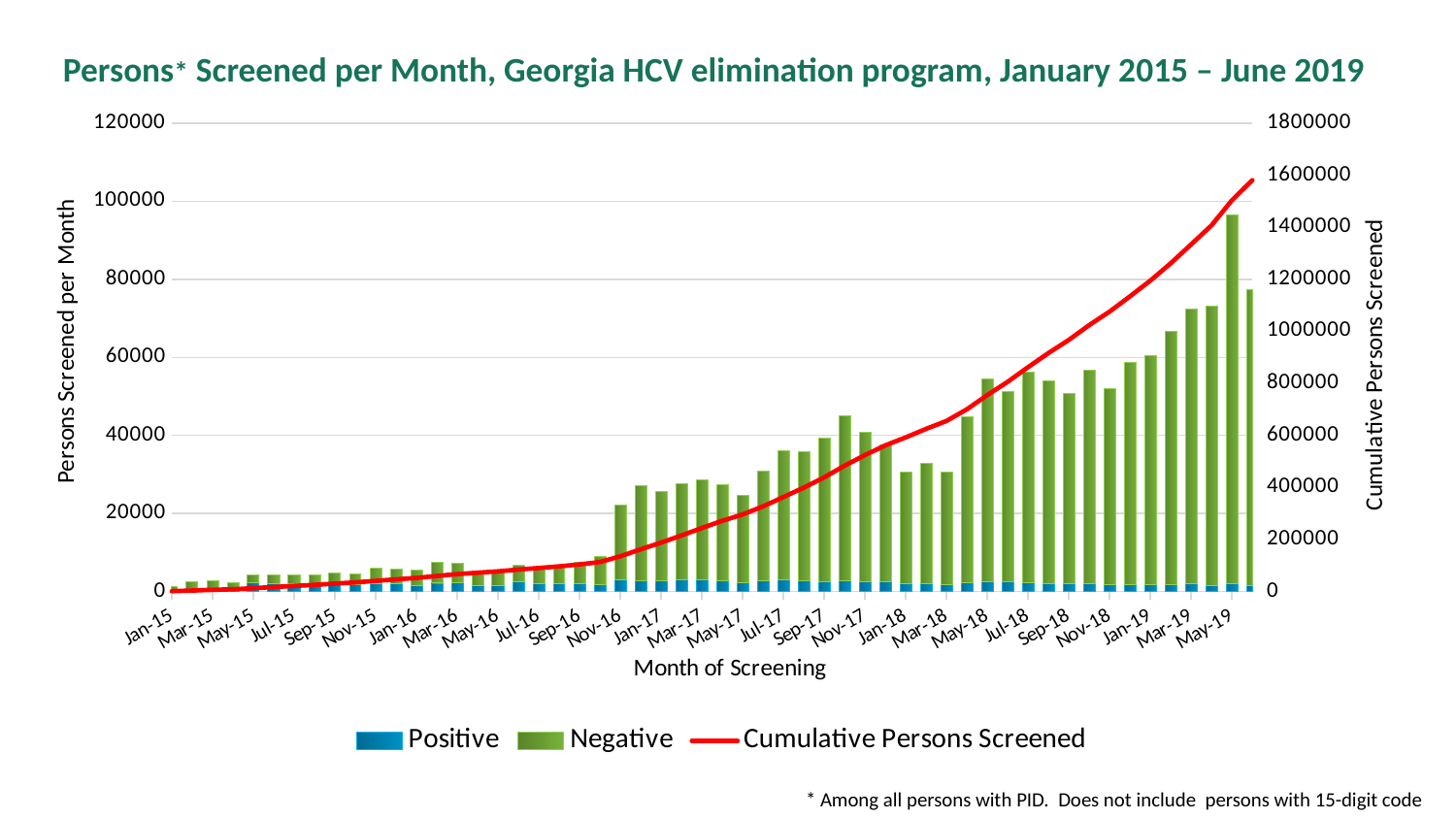
Does the Cumulative Persons Screened line rise or fall from Jan-15 to the end of the period? Rises Is the total persons screened in May-19 greater or less than 80000? greater How many series does the legend list? 3 Which labelled month has the tallest bar for persons screened per month? May-19 Is the Cumulative Persons Screened value at Jan-18 greater or less than 400000? greater What are the three series named in the legend? Positive, Negative, Cumulative Persons Screened What is the title of the right-hand vertical axis? Cumulative Persons Screened Which labelled month has the shortest bar for persons screened per month? Jan-15 Is the total persons screened in Mar-19 greater or less than 60000? greater What kind of chart is shown on the slide? A stacked bar chart combined with a line chart Which month has more persons screened, Jan-16 or Jan-17? Jan-17